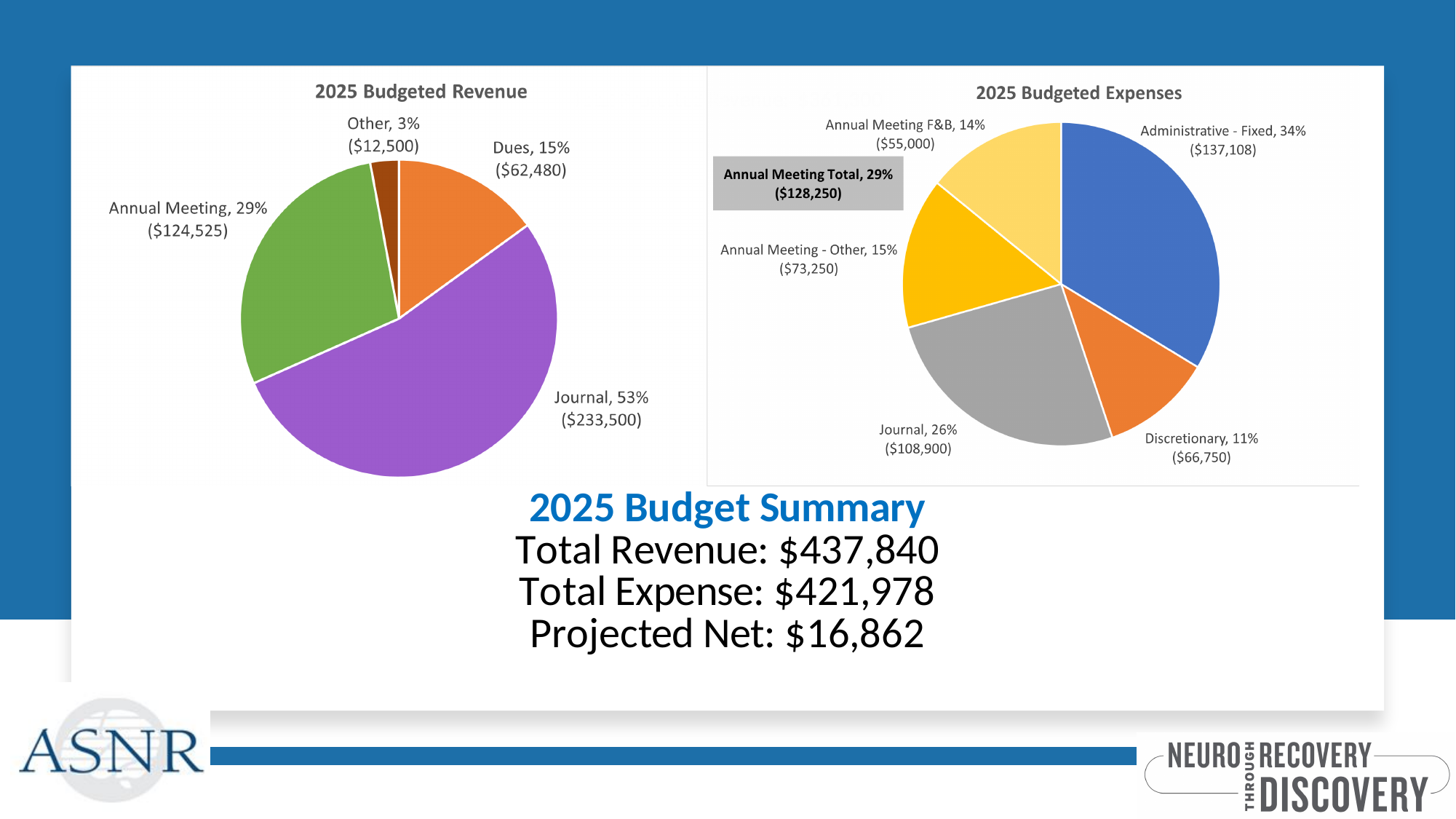
In the 2025 Budgeted Revenue chart, what is the difference between Dues and Other? $49,980 In the 2025 Budgeted Revenue chart, how many categories are shown? 4 What kind of chart is the 2025 Budgeted Expenses chart? Pie chart In the 2025 Budgeted Revenue chart, which category is the smallest? Other In the 2025 Budgeted Expenses chart, which category is the largest? Administrative - Fixed In the 2025 Budgeted Expenses chart, how many slices does the pie have? 5 In the 2025 Budgeted Revenue chart, what is the value for Journal? $233,500 In the 2025 Budgeted Expenses chart, what is the value for Administrative - Fixed? $137,108 In the 2025 Budgeted Expenses chart, what share of the pie is Discretionary? 11% In the 2025 Budgeted Revenue chart, what share of the pie is Annual Meeting? 29% In the 2025 Budgeted Revenue chart, which category is the largest? Journal In the 2025 Budgeted Expenses chart, which is larger, Journal or Annual Meeting - Other? Journal